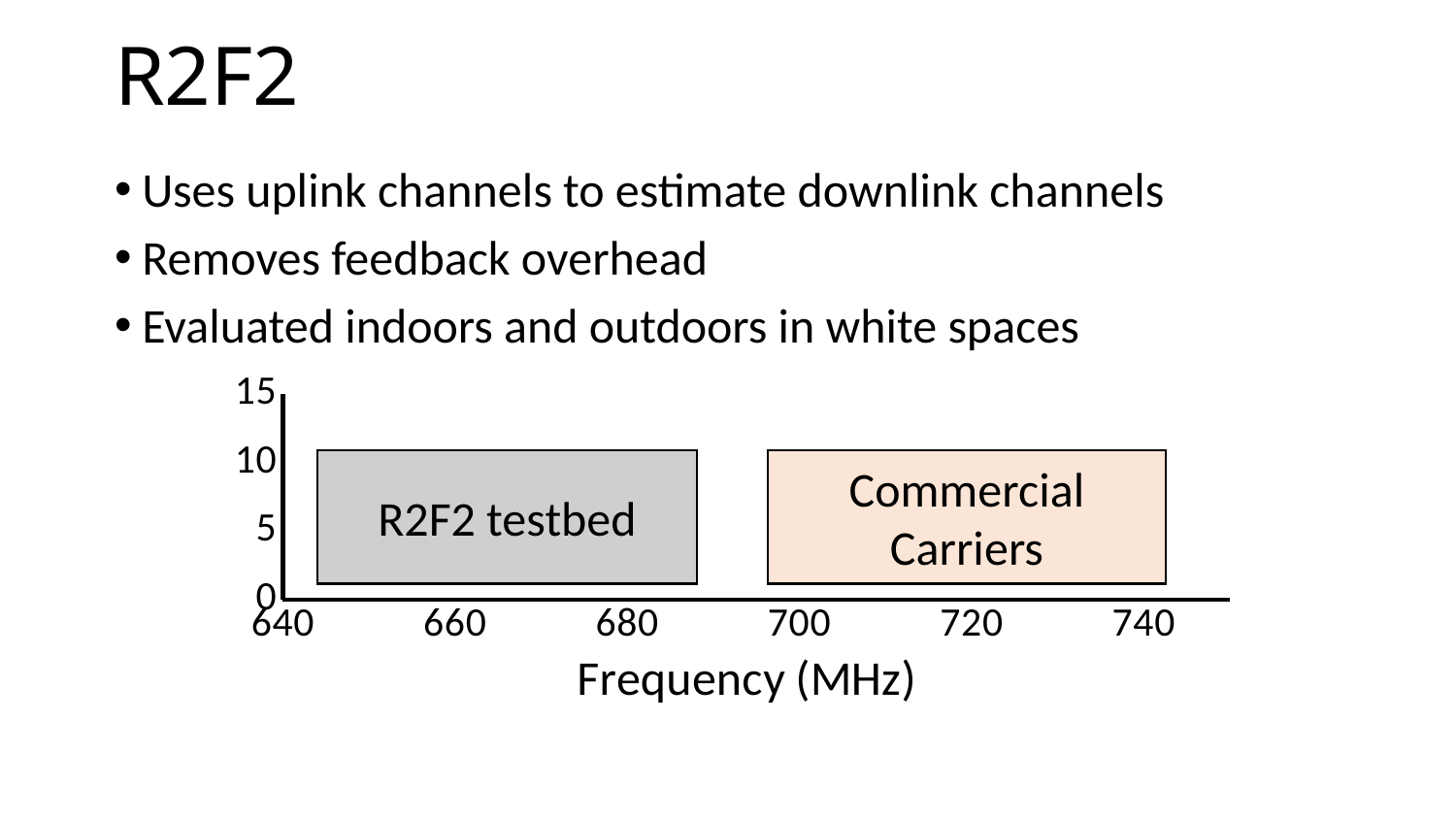
Is the frequency range of the R2F2 testbed region greater or less than 700 MHz? less How many labelled frequency regions are shown on the chart? 2 What is the highest tick value shown on the y axis? 15 Is the height of the Commercial Carriers box on the y axis greater or less than 5? greater Which region occupies the lowest frequencies on the chart? R2F2 testbed Is the height of the R2F2 testbed box on the y axis greater or less than 15? less Which region occupies the higher frequencies, R2F2 testbed or Commercial Carriers? Commercial Carriers What kind of chart is shown on the slide? bar chart What is the label on the x axis of the chart? Frequency (MHz)